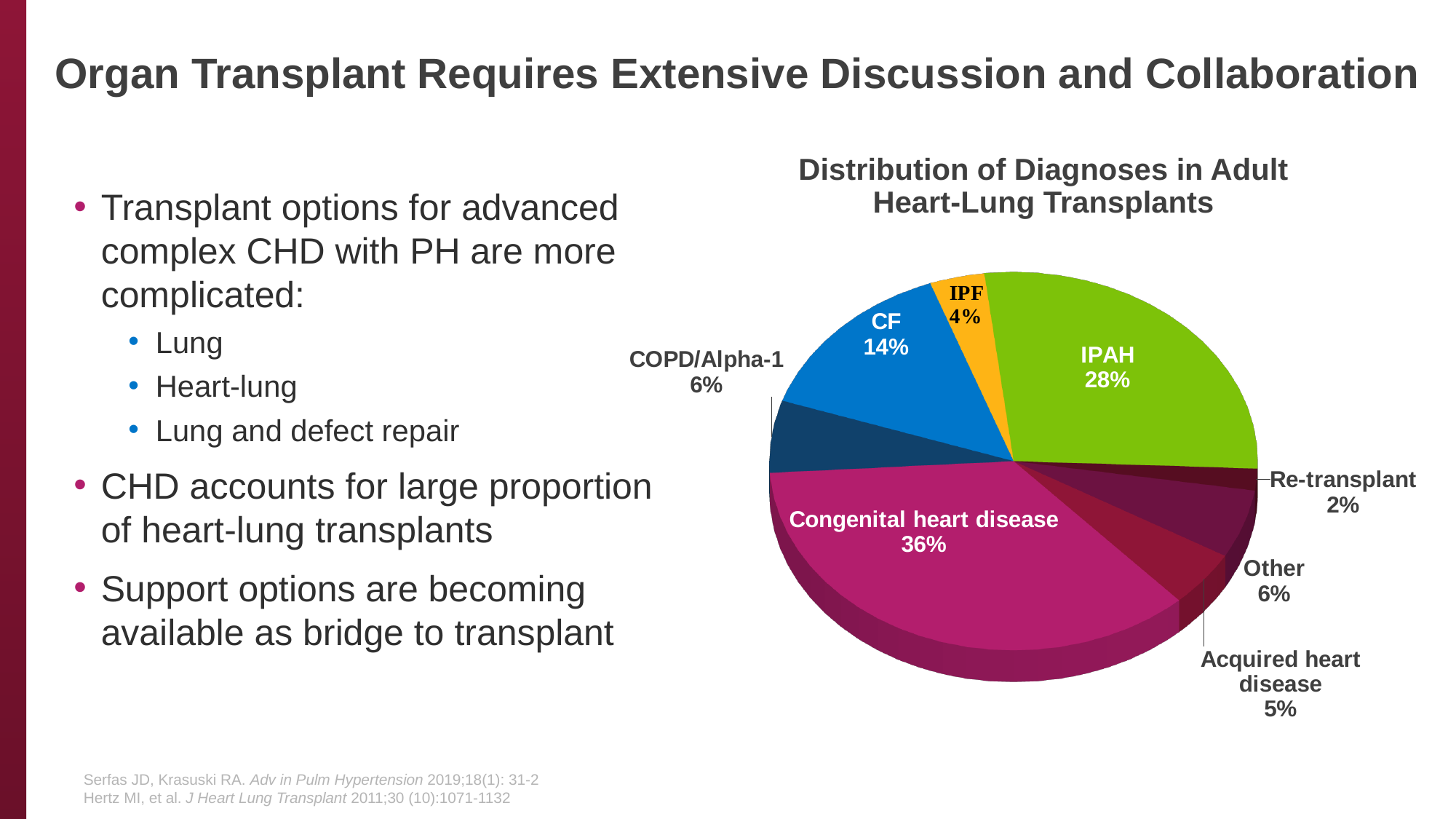
How many slices does the pie chart have? 8 What is the title of the chart? Distribution of Diagnoses in Adult Heart-Lung Transplants What percentage of the pie is IPAH? 28% What percentage is shown for Re-transplant? 2% What is the value for Acquired heart disease? 5% Which diagnosis has the largest slice of the pie? Congenital heart disease Which is larger, the share for CF or the share for IPF? CF What kind of chart is shown on the slide? Pie chart What share of adult heart-lung transplants is attributed to congenital heart disease? 36% What is the difference in percentage points between Congenital heart disease and IPAH? 8 Which diagnosis has the smallest slice of the pie? Re-transplant What is the value shown for CF? 14%